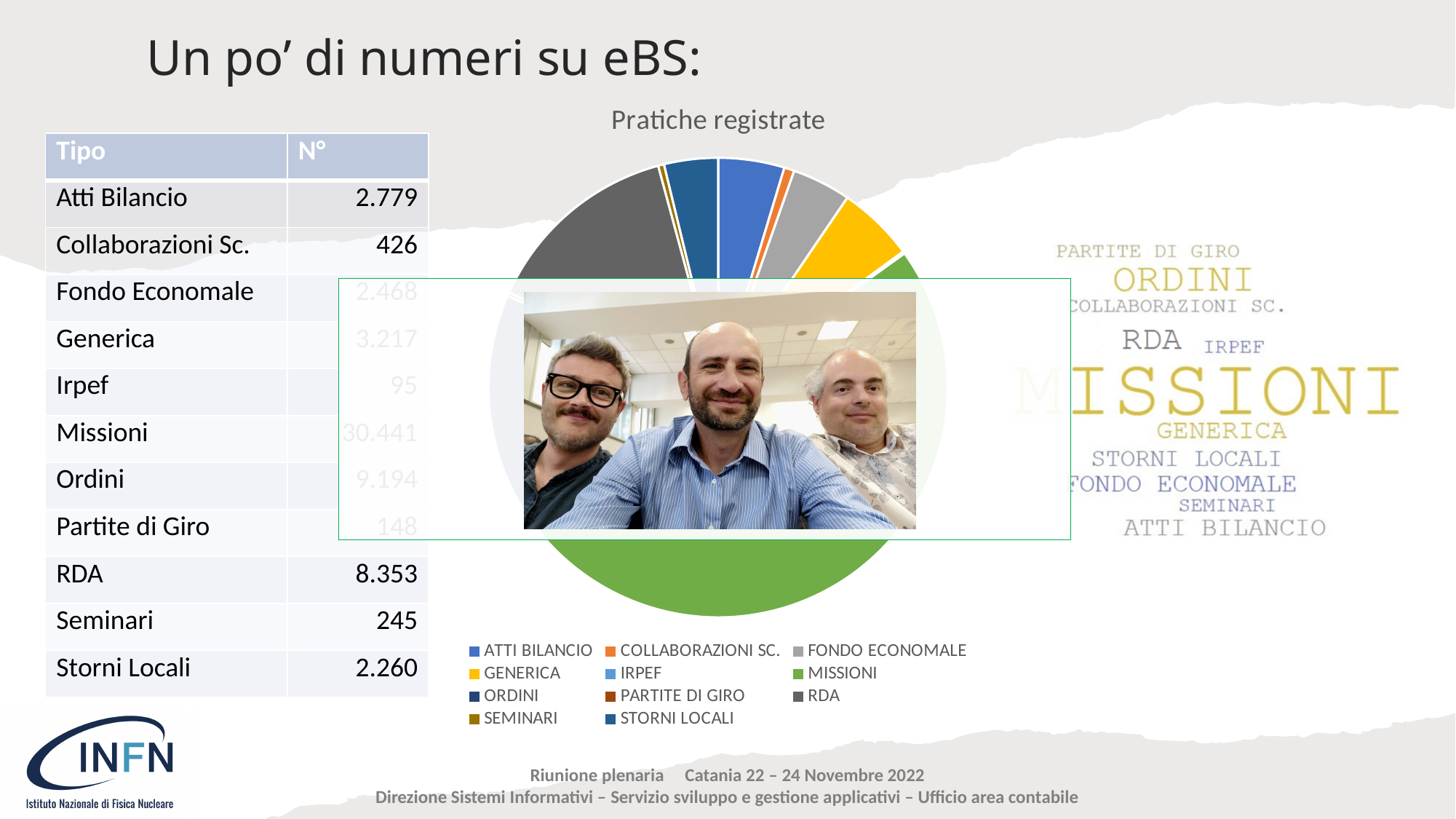
What kind of chart is shown under the title "Pratiche registrate"? pie chart In the pie chart, which slice is larger: MISSIONI or ATTI BILANCIO? MISSIONI According to the table next to the chart, what is the N° value for Storni Locali? 2.260 Which category has the largest slice in the pie chart? MISSIONI According to the table next to the chart, what is the N° value for RDA? 8.353 In the pie chart, which slice is larger: RDA or ORDINI? ORDINI According to the table next to the chart, what is the difference between the N° values for Collaborazioni Sc. and Seminari? 181 How many categories does the legend of the pie chart list? 11 What colour is the MISSIONI slice in the pie chart? green In the pie chart, which slice is larger: GENERICA or IRPEF? GENERICA According to the table next to the chart, what is the N° value for Atti Bilancio? 2.779 What is the title of the pie chart? Pratiche registrate